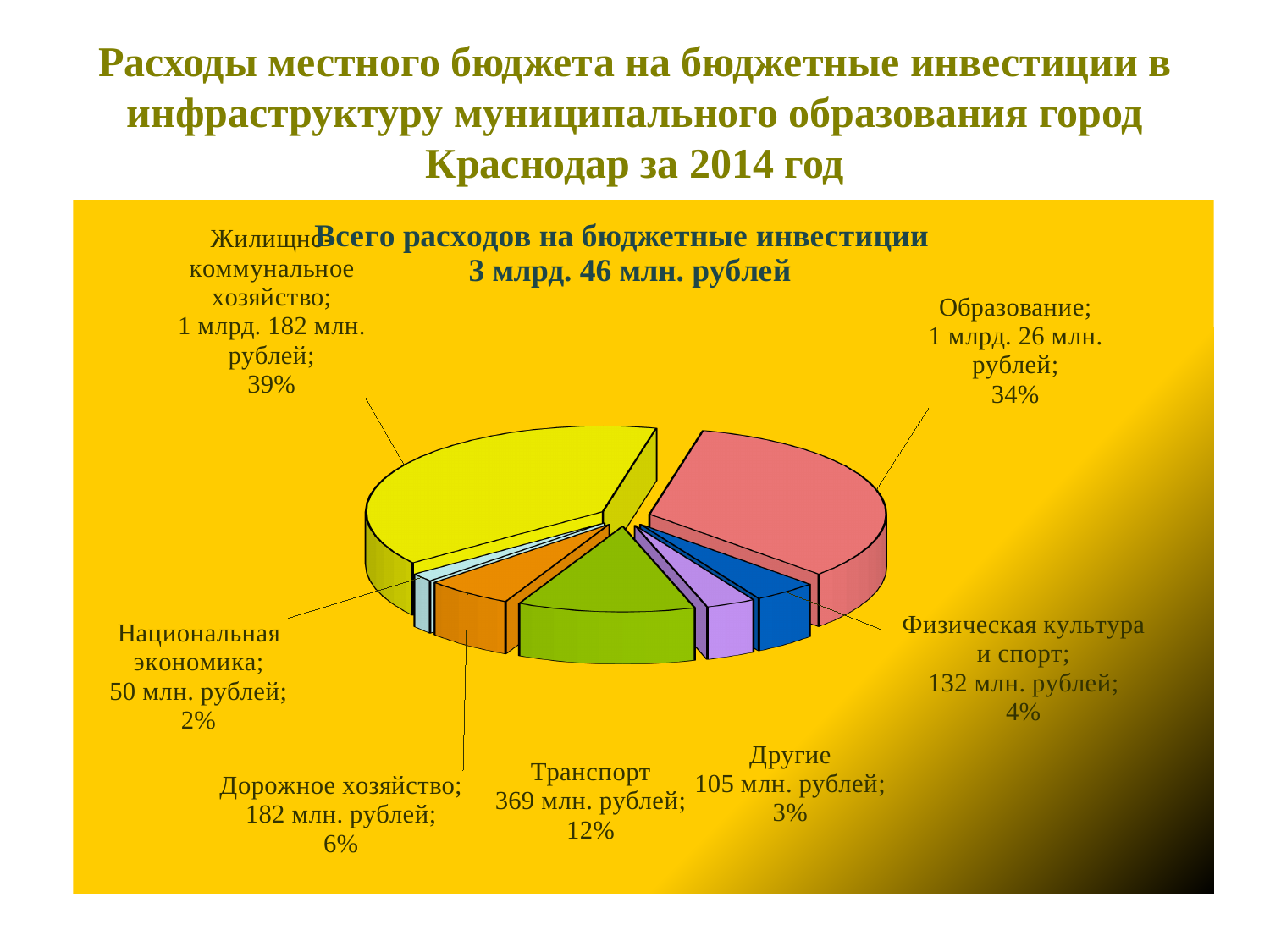
Which category has the largest share of the pie? Жилищно-коммунальное хозяйство What is the value shown for Транспорт? 369 млн. рублей What total amount of expenditure on budget investments is stated above the chart? 3 млрд. 46 млн. рублей What share of the pie does Образование account for? 34% How many categories (slices) does the pie chart have? 7 Which is larger, the value for Физическая культура и спорт or the value for Другие? Физическая культура и спорт Which category has the smallest share of the pie? Национальная экономика What is the difference between the values for Дорожное хозяйство and Национальная экономика? 132 млн. рублей What kind of chart is shown on the slide? pie chart What is the difference in percentage points between the shares of Транспорт and Дорожное хозяйство? 6% What percentage share is shown for Дорожное хозяйство? 6% What is the value shown for Жилищно-коммунальное хозяйство? 1 млрд. 182 млн. рублей